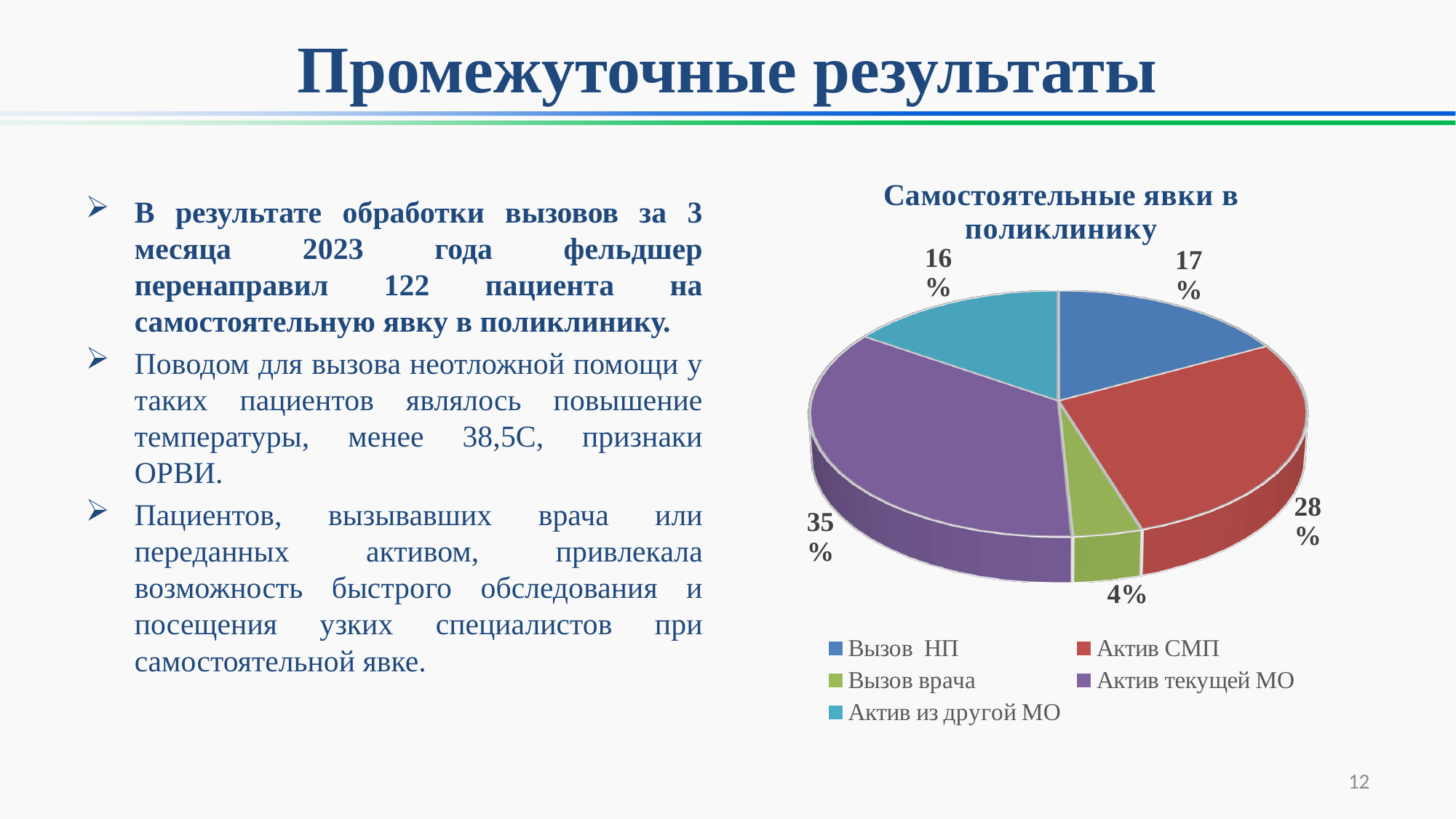
What kind of chart is shown on the slide? pie chart How many categories does the legend list? 5 What is the title of the chart? Самостоятельные явки в поликлинику What share of the pie does "Вызов НП" have? 17% Which category has the smallest slice of the pie? Вызов врача What share of the pie does "Актив СМП" have? 28% What share of the pie does "Актив текущей МО" have? 35% Which is larger, the share for "Вызов НП" or the share for "Актив из другой МО"? Вызов НП Which category has the largest slice of the pie? Актив текущей МО What is the difference in percentage points between "Актив текущей МО" and "Актив СМП"? 7